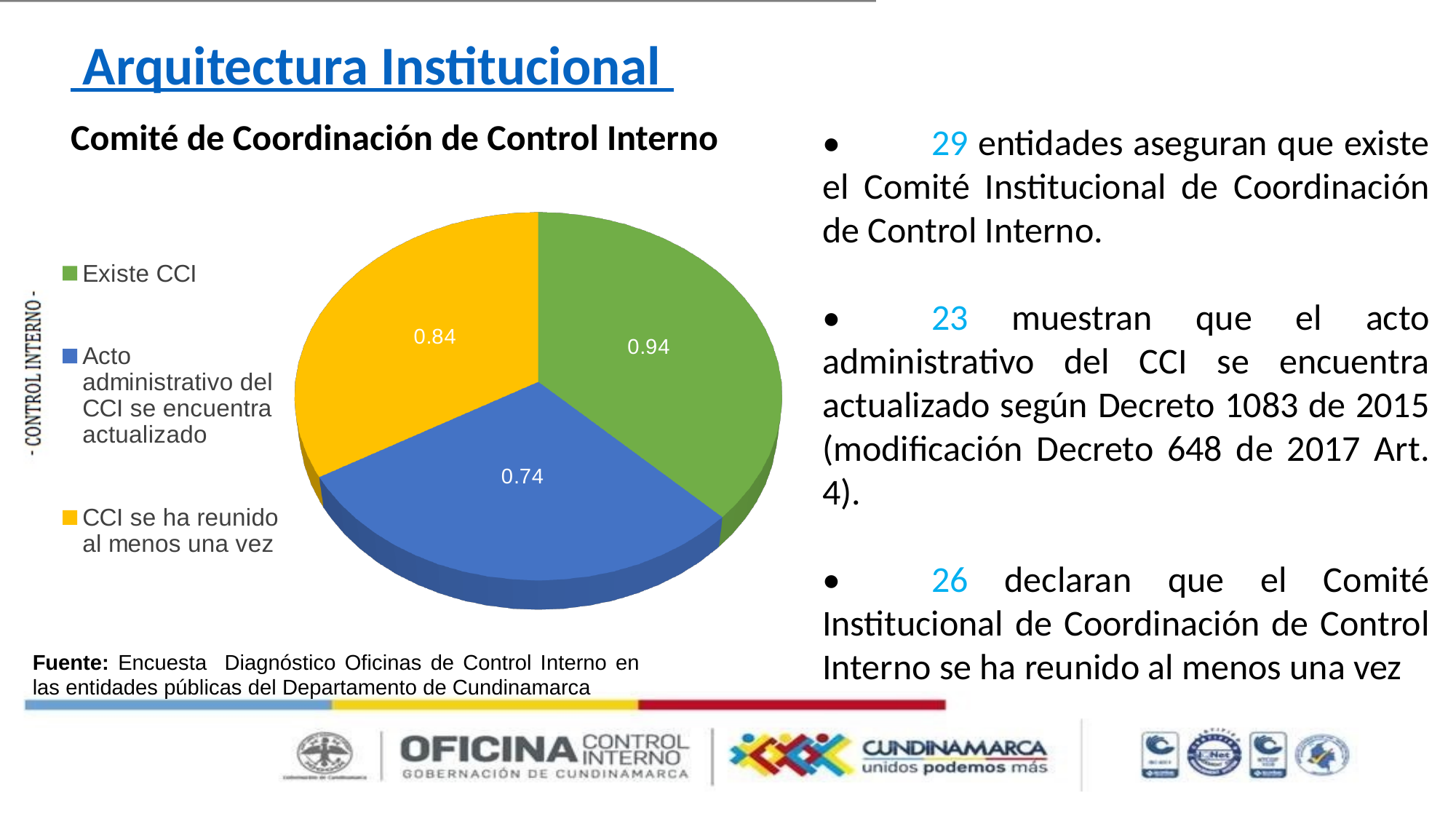
What is the title of the chart? Comité de Coordinación de Control Interno Which category has the highest value in the pie chart? Existe CCI How many slices does the pie chart have? 3 What value is shown for the 'CCI se ha reunido al menos una vez' slice? 0.84 What value is shown for the 'Existe CCI' slice? 0.94 What is the difference between the values for 'Existe CCI' and 'CCI se ha reunido al menos una vez'? 0.10 What value is shown for the 'Acto administrativo del CCI se encuentra actualizado' slice? 0.74 Which is larger: the value for 'CCI se ha reunido al menos una vez' or the value for 'Acto administrativo del CCI se encuentra actualizado'? CCI se ha reunido al menos una vez Which category has the lowest value in the pie chart? Acto administrativo del CCI se encuentra actualizado What type of chart is shown on the slide? Pie chart What colour is the 'CCI se ha reunido al menos una vez' slice? Yellow What is the difference between the values for 'Existe CCI' and 'Acto administrativo del CCI se encuentra actualizado'? 0.20